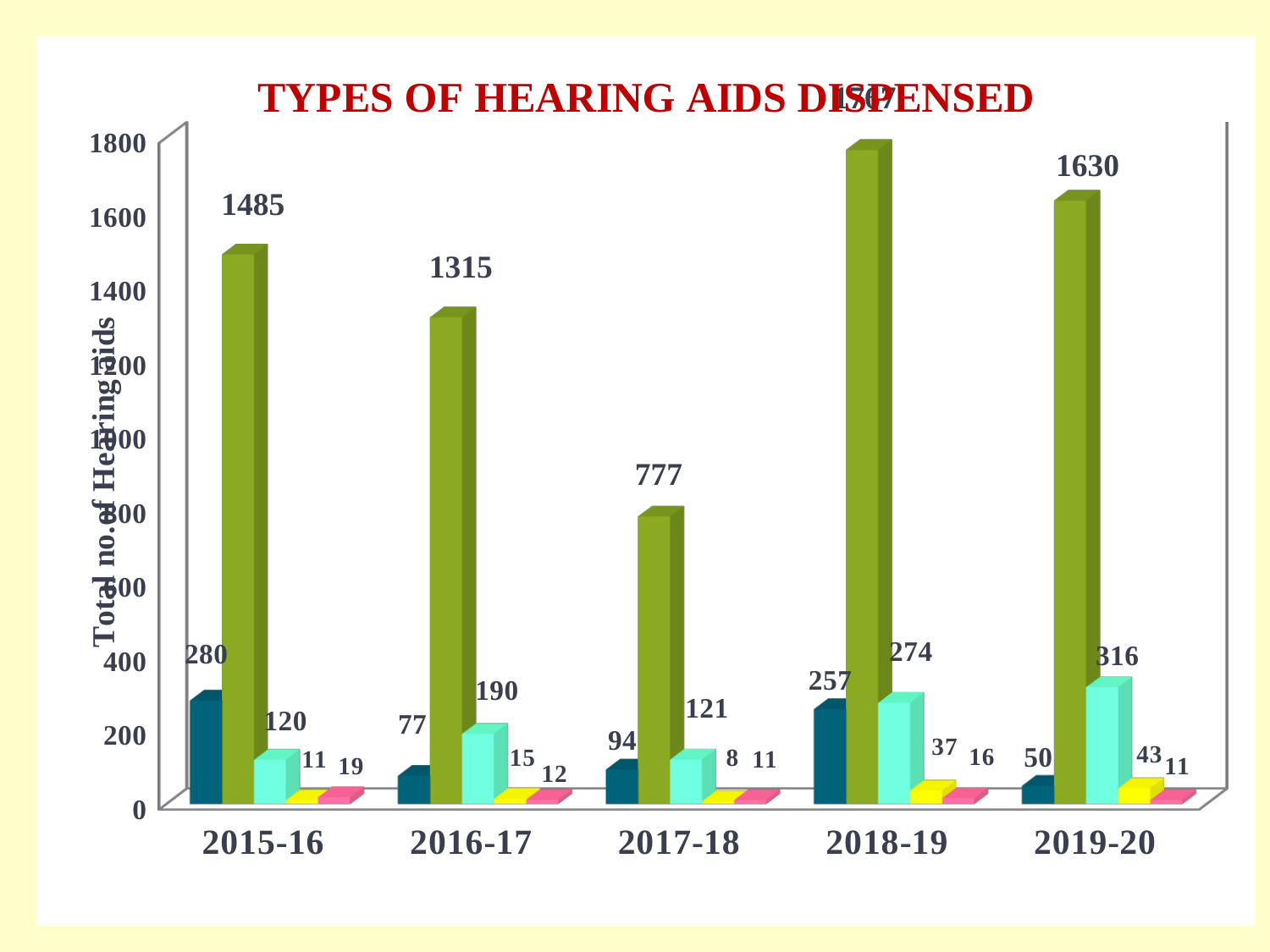
What is the value of the yellow bar for 2019-20? 43 What is the difference between the olive green bar values for 2019-20 and 2015-16? 145 Is the value of the olive green bar for 2018-19 greater or less than 1600? greater How many years are shown on the x axis? 5 What is the value of the light cyan bar for 2016-17? 190 In which year is the olive green bar the highest? 2018-19 Which is larger, the dark teal bar for 2015-16 or the dark teal bar for 2018-19? 2015-16 What is the value of the olive green bar for 2019-20? 1630 In which year is the olive green bar the lowest? 2017-18 What is the value of the olive green bar for 2015-16? 1485 What is the value of the dark teal bar for 2018-19? 257 What is the title of the chart? TYPES OF HEARING AIDS DISPENSED